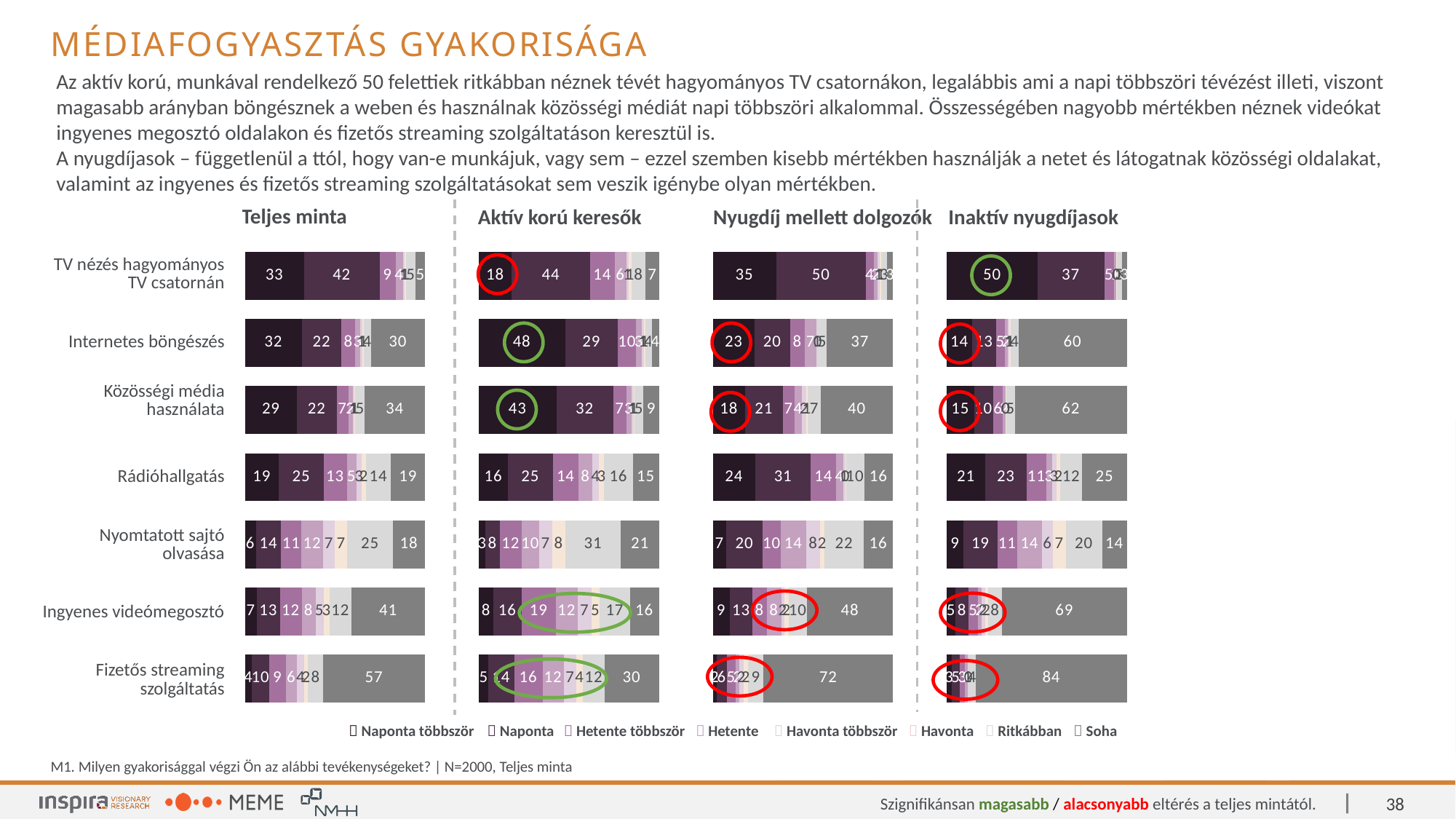
In the Aktív korú keresők chart, what is the 'Naponta többször' value for Internetes böngészés? 48 How many activities (categories) are shown in each chart? 7 In the Nyugdíj mellett dolgozók chart, what is the 'Naponta' value for TV nézés hagyományos TV csatornán? 50 In the Teljes minta chart, what is the difference between the 'Soha' values for Fizetős streaming szolgáltatás and Ingyenes videómegosztó? 16 In the Aktív korú keresők chart, which activity has the lowest 'Naponta többször' value? Nyomtatott sajtó olvasása Which is larger: the 'Naponta többször' value for TV nézés hagyományos TV csatornán in the Aktív korú keresők chart or in the Inaktív nyugdíjasok chart? Inaktív nyugdíjasok In the Inaktív nyugdíjasok chart, what is the 'Soha' value for Fizetős streaming szolgáltatás? 84 How many frequency series does the legend list? 8 In the Inaktív nyugdíjasok chart, which activity has the highest 'Soha' value? Fizetős streaming szolgáltatás What is the title of the chart on the far right of the slide? Inaktív nyugdíjasok What type of chart is used on this slide? Stacked bar chart In the Teljes minta chart, what percentage of respondents watch TV on traditional channels 'Naponta többször'? 33